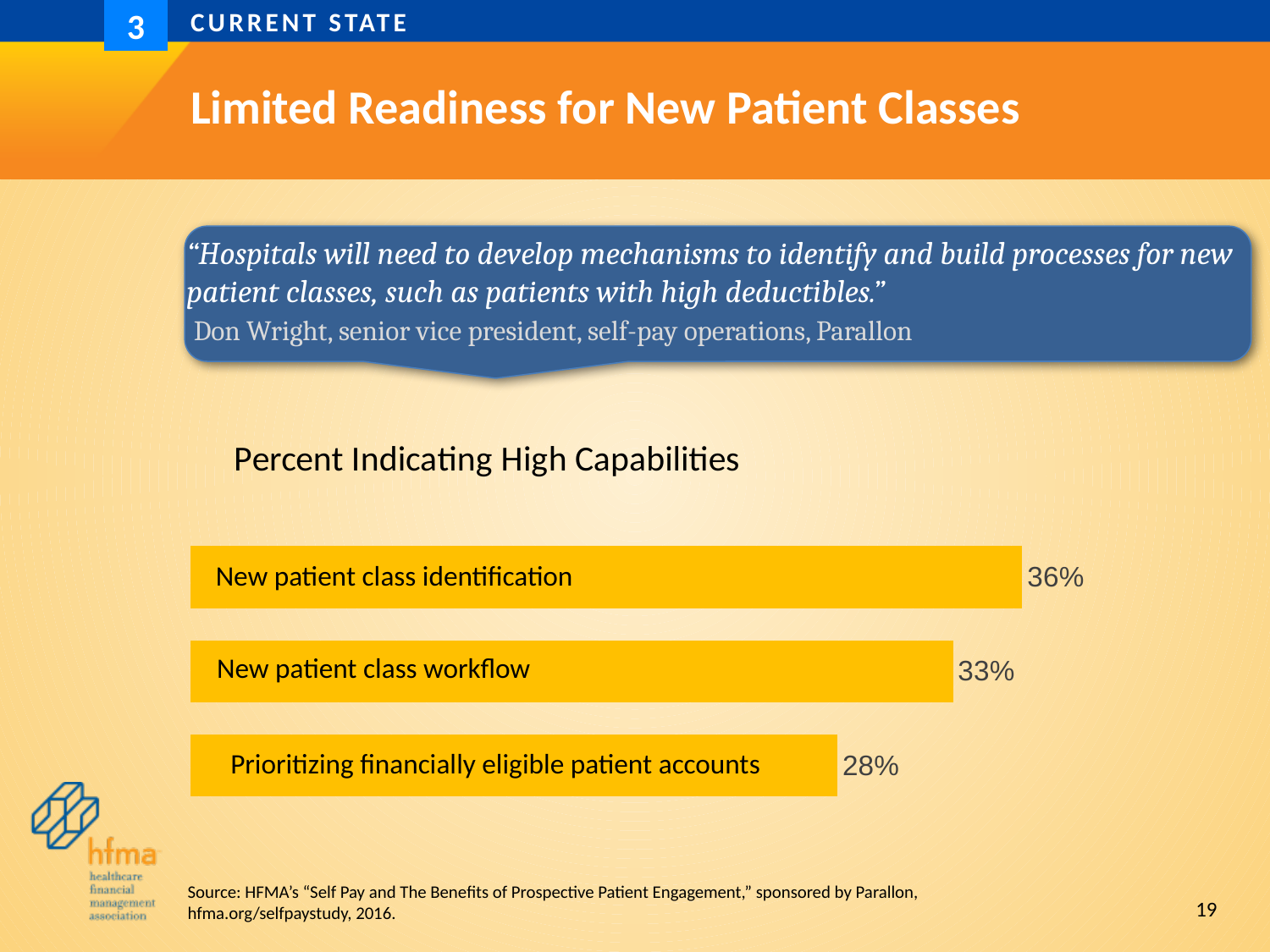
What colour are the bars in the chart? Yellow What is the difference in percentage points between New patient class identification and Prioritizing financially eligible patient accounts? 8 Which is larger: the value for New patient class workflow or for Prioritizing financially eligible patient accounts? New patient class workflow How many categories are shown in the chart? 3 Which category has the highest percent indicating high capabilities? New patient class identification What percent indicated high capabilities for Prioritizing financially eligible patient accounts? 28% What is the difference in percentage points between New patient class identification and New patient class workflow? 3 What kind of chart is shown on the slide? Bar chart What is the title of the chart? Percent Indicating High Capabilities What percent indicated high capabilities for New patient class identification? 36% What percent indicated high capabilities for New patient class workflow? 33% Which category has the lowest percent indicating high capabilities? Prioritizing financially eligible patient accounts